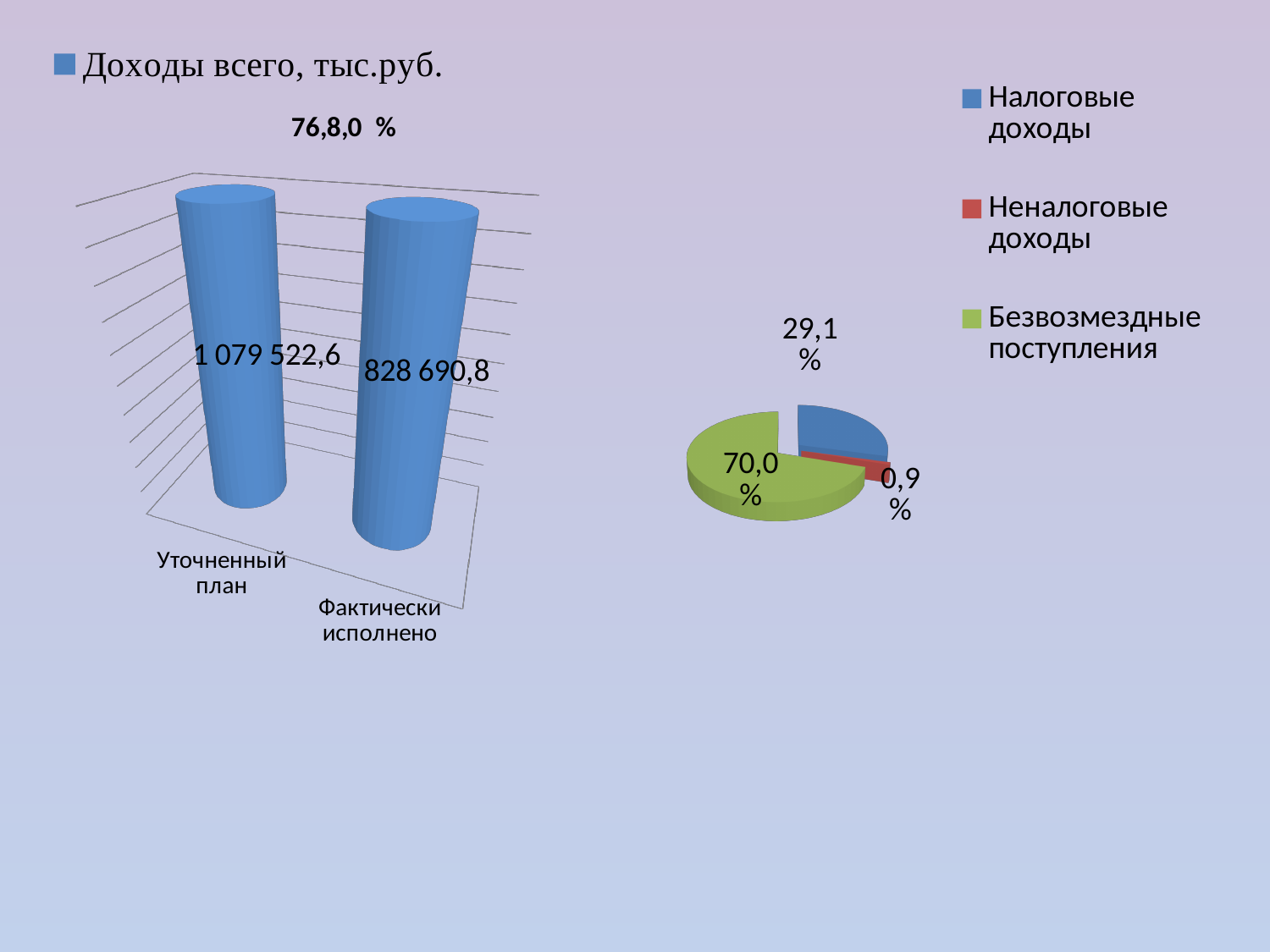
On the left chart, what is the value for Фактически исполнено? 828 690,8 On the left chart, what is the value for Уточненный план? 1 079 522,6 On the left chart, what is the difference between Уточненный план and Фактически исполнено? 250 831,8 On the left chart, what series name does the legend show? Доходы всего, тыс.руб. On the right pie chart, how many entries does the legend list? 3 On the right pie chart, what share is shown for Налоговые доходы? 29,1 % On the right pie chart, which category has the smallest slice? Неналоговые доходы On the right pie chart, what share is shown for Безвозмездные поступления? 70,0 % On the left chart, which category has the lower value? Фактически исполнено What kind of chart is the left chart? bar chart On the left chart, how many categories are shown? 2 On the left chart, which category has the higher value? Уточненный план